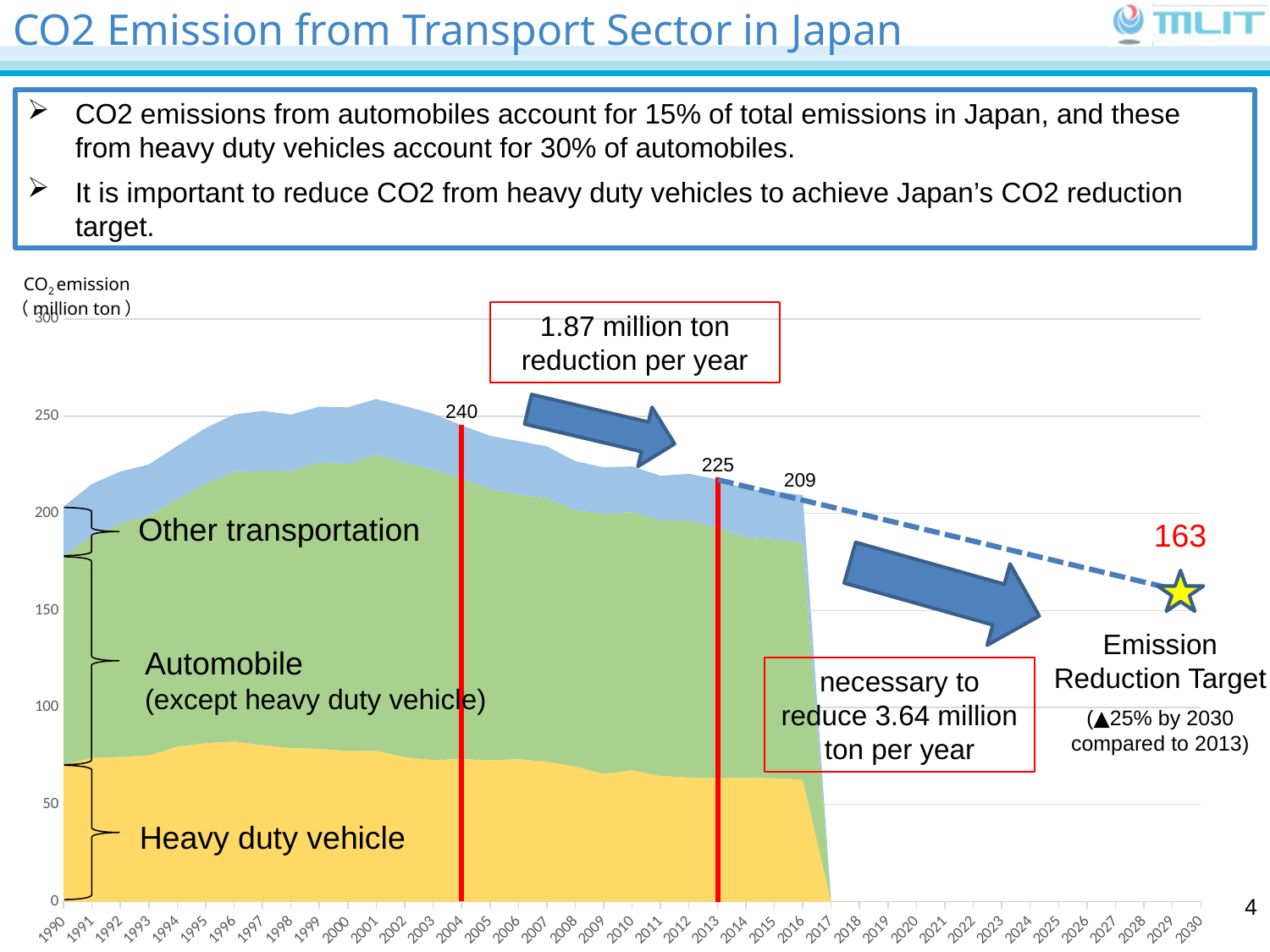
What is the difference between the 2013 labeled value and the 2030 target value? 62 What is the total CO2 emission value labeled for 2013 on the chart? 225 According to the chart annotation, what is the emission reduction target by 2030 compared to 2013? ▲25% Is the Heavy duty vehicle emission in 2013 greater or less than 100 million ton? less Which year has the larger labeled total emission, 2004 or 2013? 2004 What kind of chart is used to show the CO2 emissions? Stacked area chart What is the total CO2 emission value labeled for 2004 on the chart? 240 What emission value is labeled at the 2030 emission reduction target (the star)? 163 Does the total CO2 emission rise or fall between 2004 and 2013? Fall How many emission categories are stacked in the chart? 3 What value is labeled at the end of the shaded area, just after the 225 label? 209 What is the difference between the labeled values for 2004 and 2013? 15